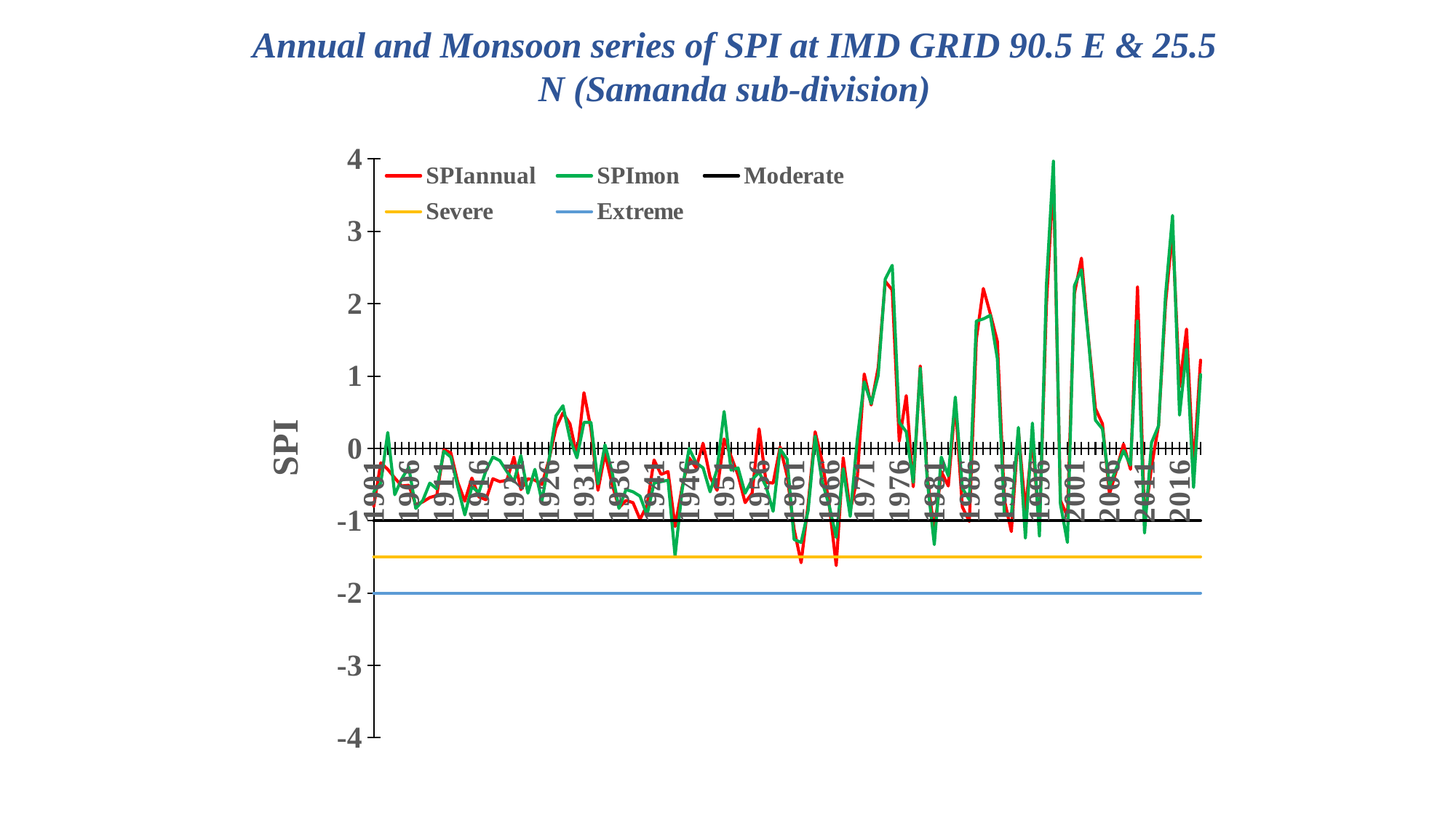
Is the highest peak of the SPImon series greater or less than 3? greater What is the title of the chart? Annual and Monsoon series of SPI at IMD GRID 90.5 E & 25.5 N (Samanda sub-division) What is the label on the vertical axis? SPI What is the highest value shown on the vertical axis? 4 Which of the three reference lines (Moderate, Severe, Extreme) is the lowest on the chart? Extreme What kind of chart is shown on the slide? line chart Which series reaches a higher peak value, SPIannual or SPImon? SPImon At what SPI value does the Moderate reference line sit? -1 Is the Severe reference line greater or less than -1? less How many series does the legend list? 5 At what SPI value does the Extreme reference line sit? -2 Is the Severe reference line greater or less than -2? greater